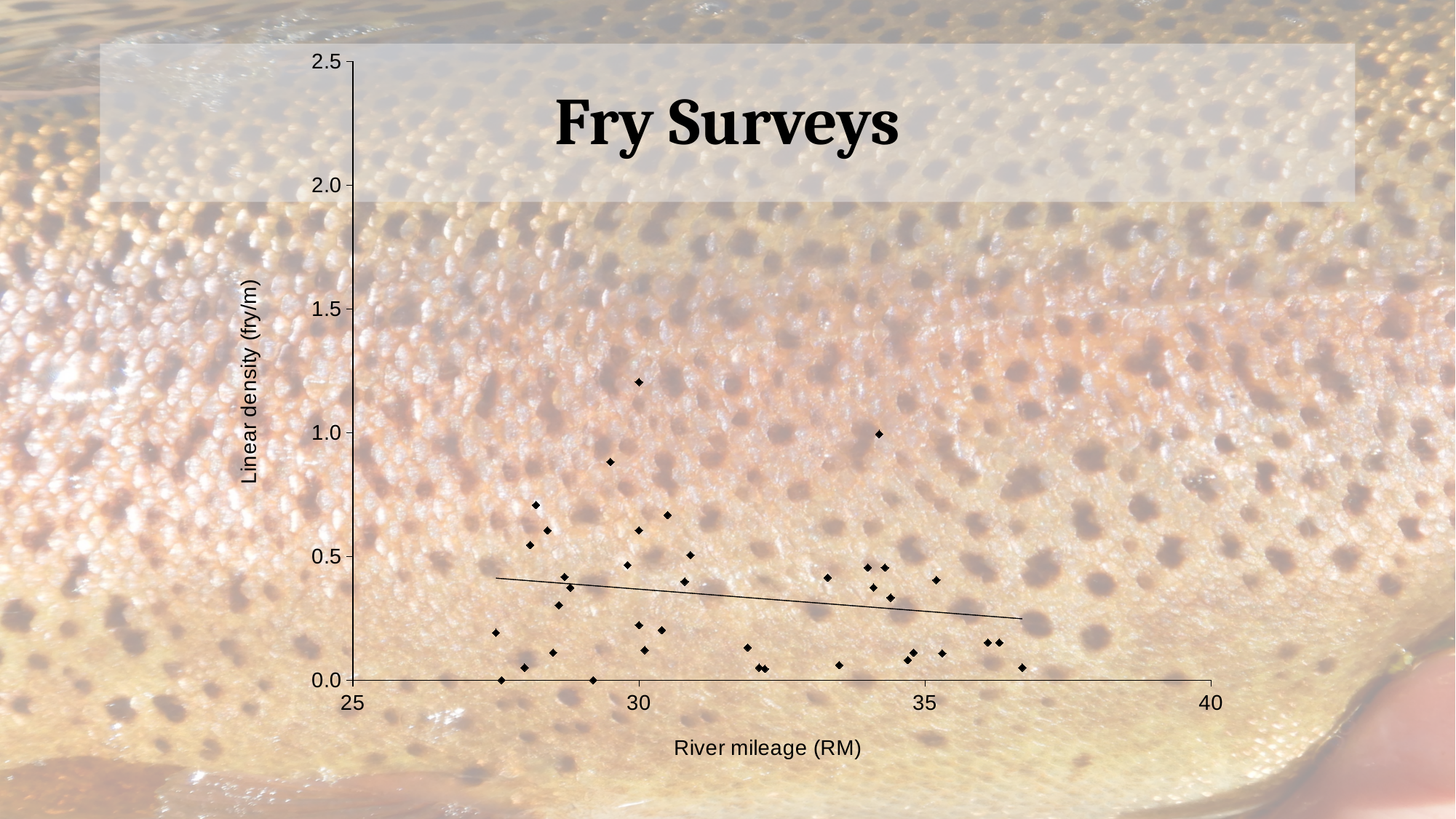
What is the lowest linear density value plotted? 0.0 What is the label of the y axis? Linear density (fry/m) What is the title of the chart? Fry Surveys What kind of chart is shown on the slide? scatter chart Is the trend line value at river mile 35 greater or less than 0.5? less Is the highest plotted density value greater or less than 1.0? greater Does the trend line rise or fall as river mileage increases? fall Is the trend line value at river mile 30 greater or less than 0.5? less Which has the higher density: the highest point near river mile 30 or the highest point near river mile 34? the point near river mile 30